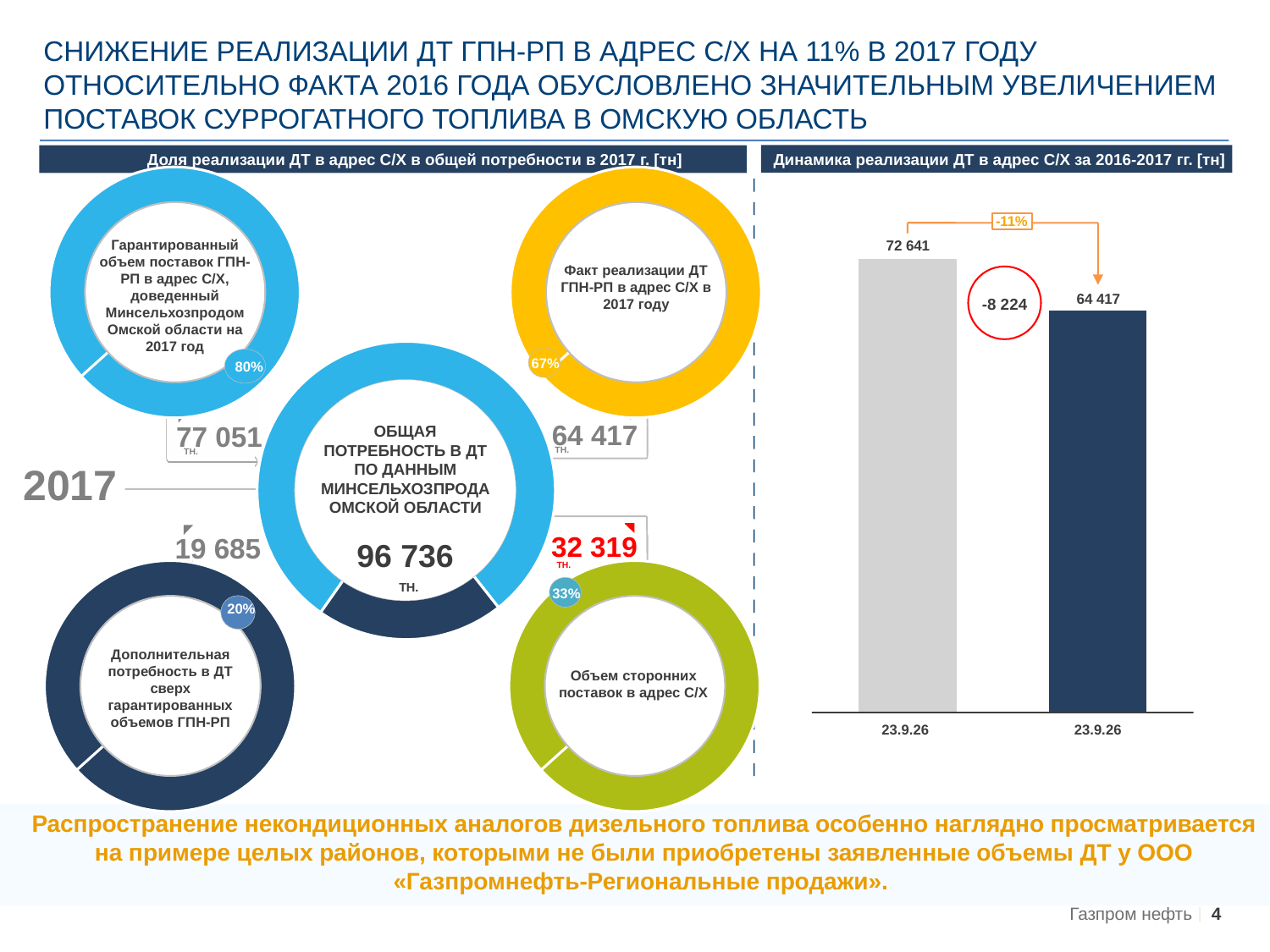
On the left side of the slide, what value in tonnes is shown in the centre of the large ring chart labelled 'ОБЩАЯ ПОТРЕБНОСТЬ В ДТ ПО ДАННЫМ МИНСЕЛЬХОЗПРОДА ОМСКОЙ ОБЛАСТИ'? 96 736 On the left side of the slide, what percentage is shown on the yellow ring chart labelled 'Факт реализации ДТ ГПН-РП в адрес С/Х в 2017 году'? 67% On the bar chart on the right of the slide, what is the difference between the left bar (72 641) and the right bar (64 417)? 8 224 On the bar chart titled 'Динамика реализации ДТ в адрес С/Х за 2016-2017 гг. [тн]', what is the value of the left (grey) bar? 72 641 On the bar chart on the right of the slide, do the values rise or fall from the left bar to the right bar? fall On the bar chart titled 'Динамика реализации ДТ в адрес С/Х за 2016-2017 гг. [тн]', what is the value of the right (dark blue) bar? 64 417 How many bars are plotted on the bar chart titled 'Динамика реализации ДТ в адрес С/Х за 2016-2017 гг. [тн]'? 2 On the bar chart on the right of the slide, which bar is higher, the left grey bar or the right dark blue bar? the left grey bar On the bar chart on the right of the slide, what percentage change is shown between the two bars? -11% On the left side of the slide, what percentage is shown on the green ring chart labelled 'Объем сторонних поставок в адрес С/Х'? 33% On the left side of the slide, what percentage is shown on the light blue ring chart labelled 'Гарантированный объем поставок ГПН-РП в адрес С/Х'? 80% What kind of chart is shown on the right side of the slide under the title 'Динамика реализации ДТ в адрес С/Х за 2016-2017 гг. [тн]'? bar chart